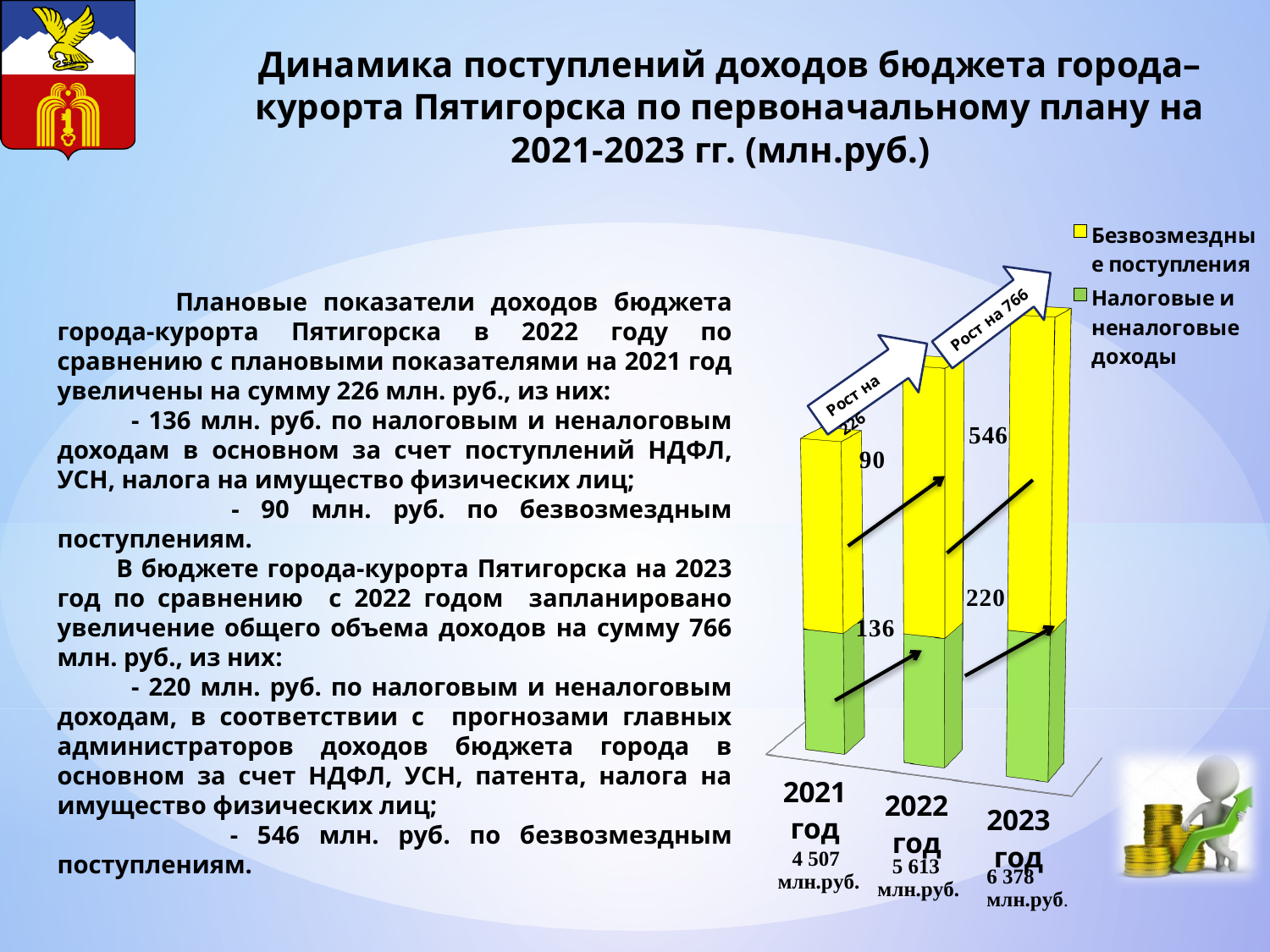
Which year has the lowest total budget revenue on the chart? 2021 год What total budget revenue is printed for 2022 год? 5 613 млн.руб. Which year has the highest total budget revenue on the chart? 2023 год Do the total budget revenues rise or fall from 2021 to 2023? Rise What total budget revenue is printed for 2021 год? 4 507 млн.руб. What kind of chart is shown on the slide? Stacked bar chart Which series is shown in green on the chart? Налоговые и неналоговые доходы How many series does the chart legend list? 2 What total budget revenue is printed for 2023 год? 6 378 млн.руб. How many years (categories) are shown on the chart? 3 Which is larger, the total for 2022 год or the total for 2021 год? 2022 год What growth amount is written on the arrow between the 2022 and 2023 bars? Рост на 766